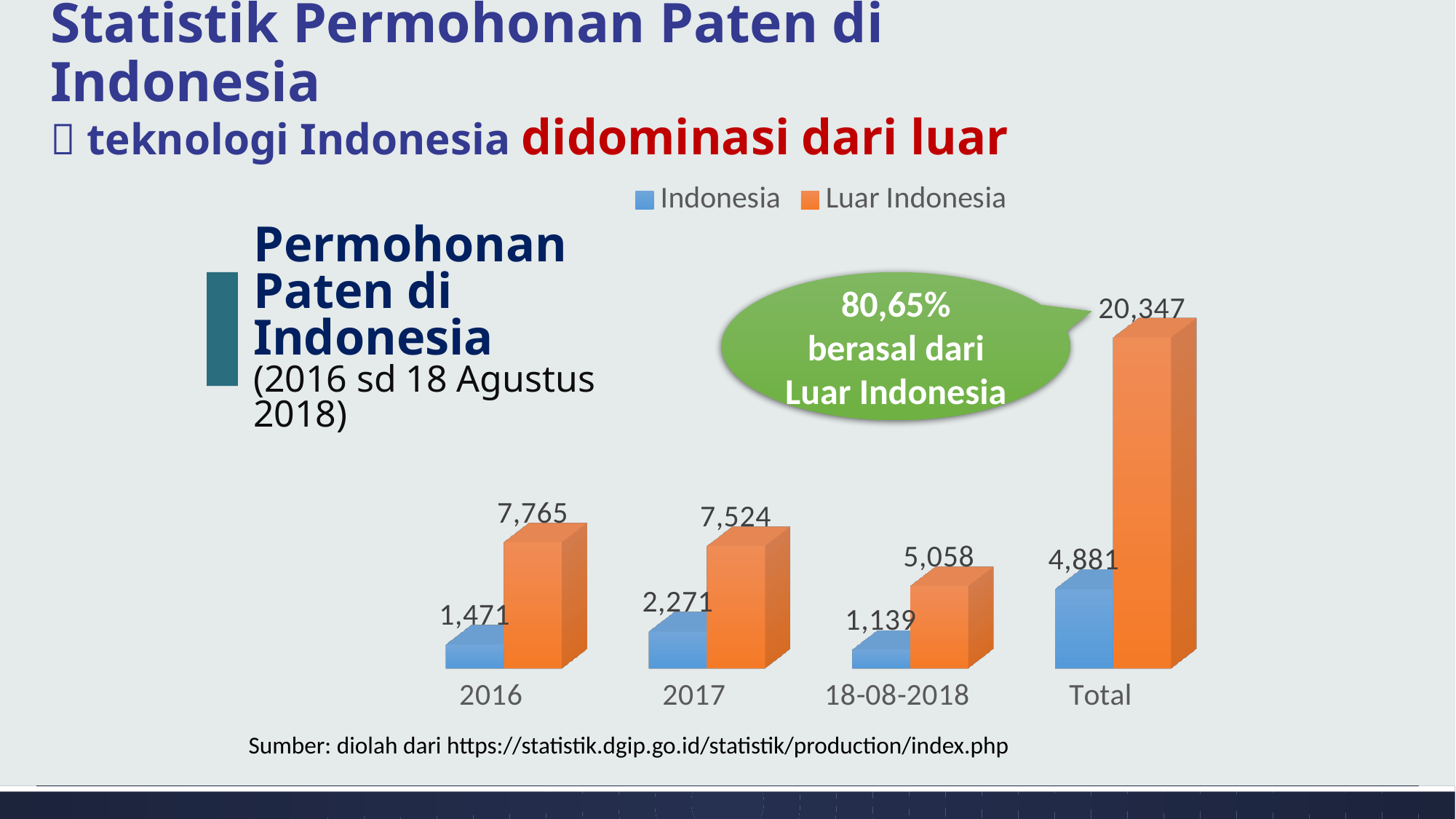
How many categories are shown on the x axis? 4 How many series does the legend list? 2 Which colour represents the Luar Indonesia series? Orange What kind of chart is shown on the slide? Bar chart Which is larger in 2017: Indonesia or Luar Indonesia? Luar Indonesia What is the value for Indonesia for 18-08-2018? 1,139 Which category has the highest value for the Indonesia series? Total What is the difference between Luar Indonesia and Indonesia in 2016? 6,294 What is the value for Luar Indonesia in the Total category? 20,347 What is the value for Luar Indonesia in 2017? 7,524 Excluding the Total category, which year has the lowest value for Luar Indonesia? 18-08-2018 What is the value for Indonesia in 2016? 1,471